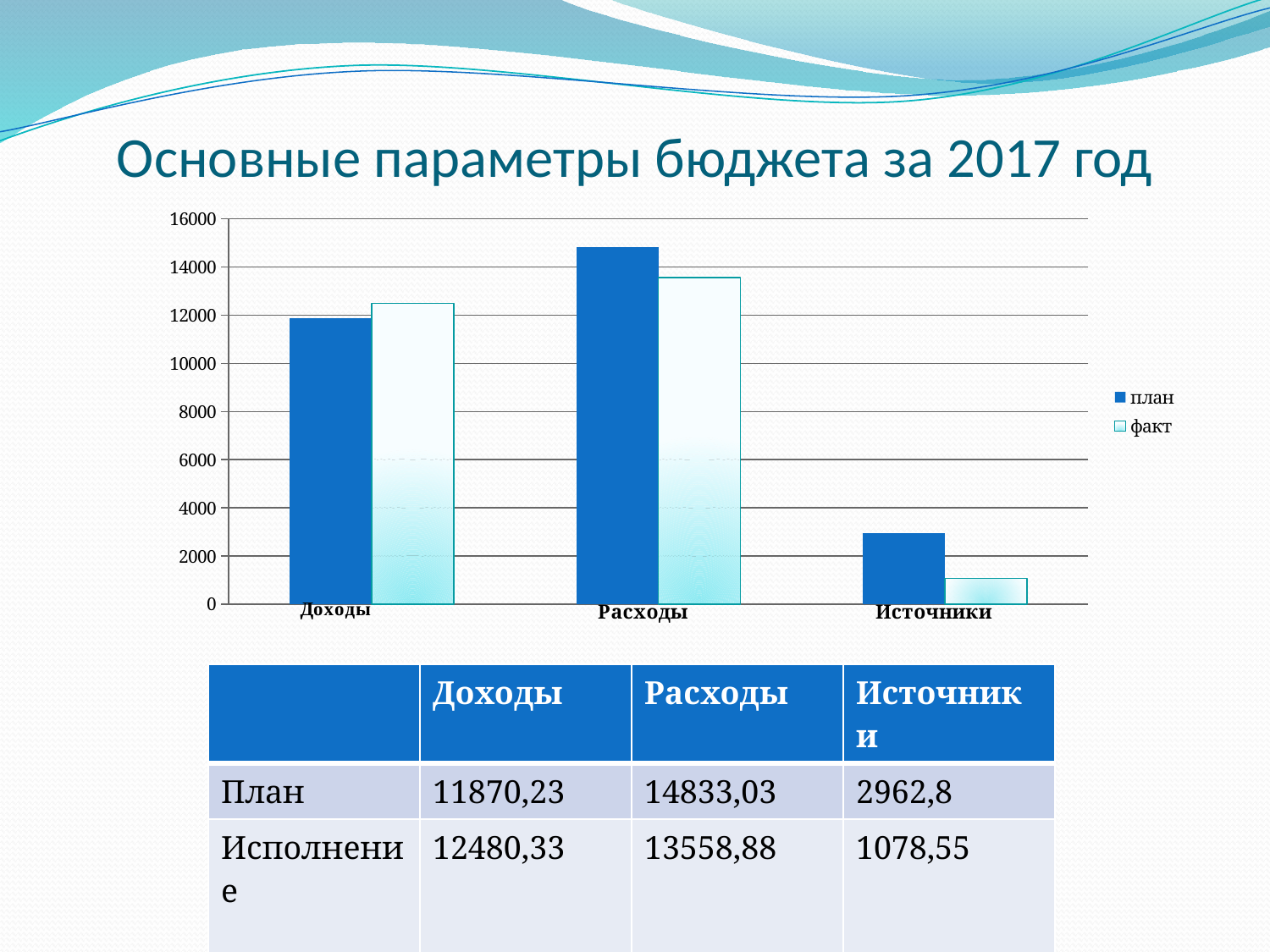
How many categories are shown on the x axis of the chart? 3 According to the table under the chart, what is the План value for Доходы? 11870,23 How many series does the chart legend list? 2 Using the table values, what is the difference between План and Исполнение for Расходы? 1274,15 What kind of chart is shown on the slide? bar chart According to the table under the chart, what is the Исполнение value for Источники? 1078,55 Is the план value for Расходы greater or less than 14000? greater Is the факт value for Источники greater or less than 2000? less Which category has the highest план (plan) bar? Расходы For Доходы, which is larger: the план bar or the факт bar? факт Which category has the lowest факт (actual) bar? Источники For Расходы, which is larger: the план bar or the факт bar? план